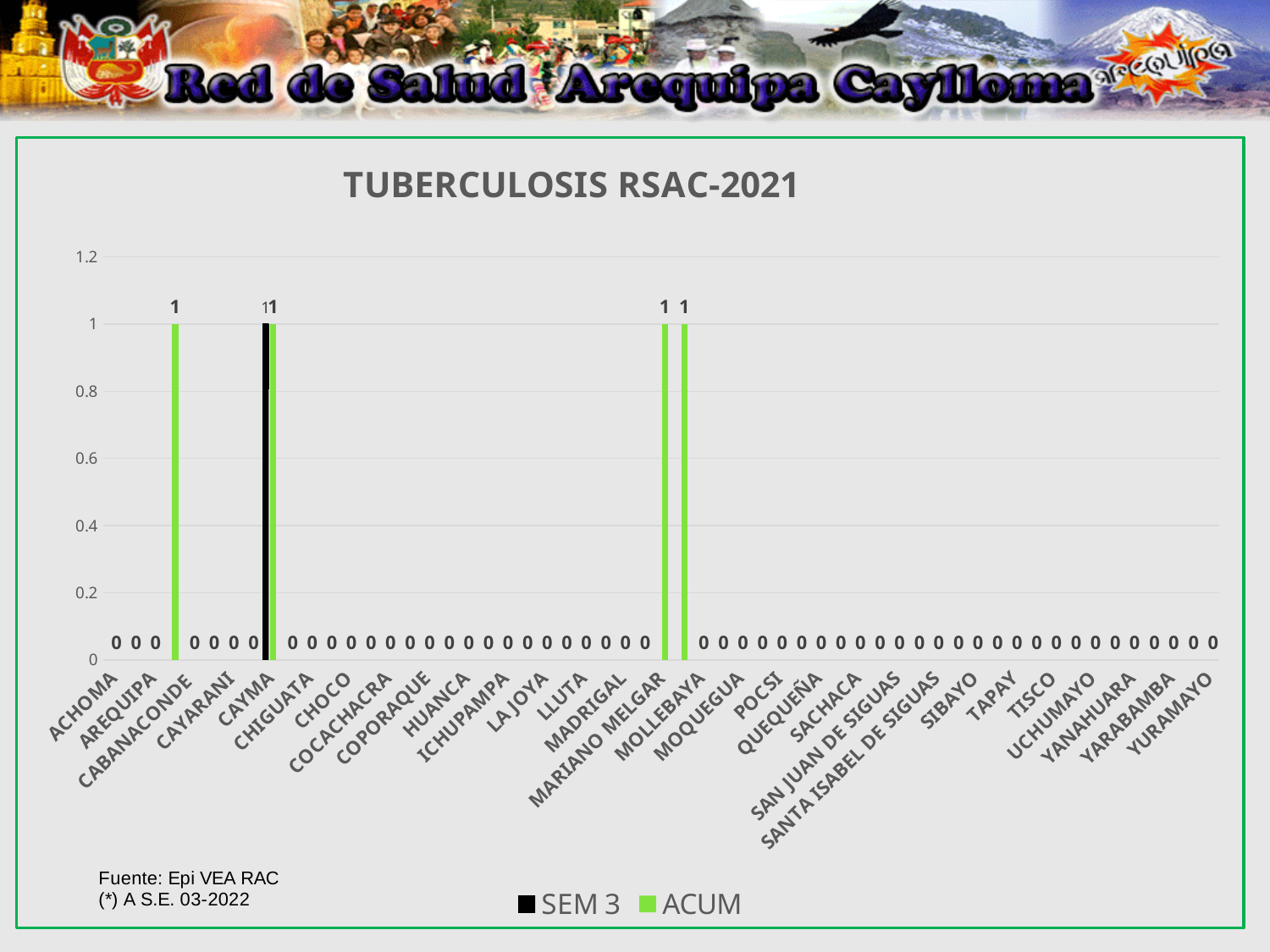
Which has the larger ACUM value, CAYMA or ACHOMA? CAYMA How many series does the legend list? 2 What is the ACUM value for CAYMA? 1 What is the ACUM value for YURAMAYO? 0 Which series is shown in black in the legend? SEM 3 What is the ACUM value for CHIGUATA? 0 What is the SEM 3 value for CAYMA? 1 What kind of chart is shown on the slide? bar chart What is the title of the chart? TUBERCULOSIS RSAC-2021 Is the ACUM value for CAYMA greater or less than 0.6? greater